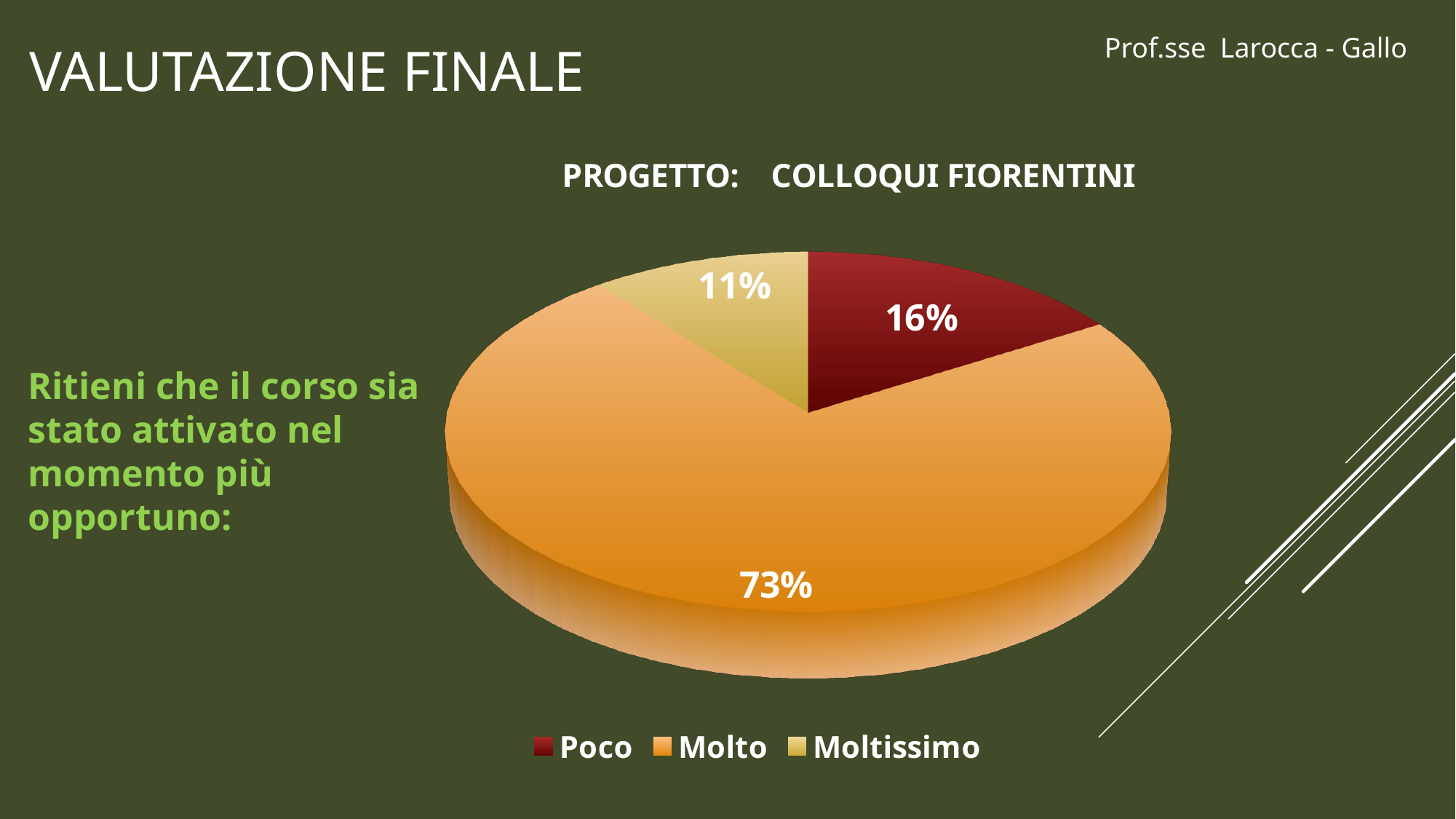
Which is larger, the share for Poco or the share for Moltissimo? Poco What is the title of the chart? PROGETTO: COLLOQUI FIORENTINI What is the difference in percentage points between Poco and Moltissimo? 5 Which category has the smallest share of the pie? Moltissimo Which category has the largest share of the pie? Molto What type of chart is shown on the slide? Pie chart What percentage of the pie is labelled Poco? 16% What percentage of the pie is labelled Molto? 73% What is the difference in percentage points between Molto and Poco? 57 How many categories does the pie chart have? 3 What colour is the Poco slice in the pie chart? Dark red What percentage of the pie is labelled Moltissimo? 11%